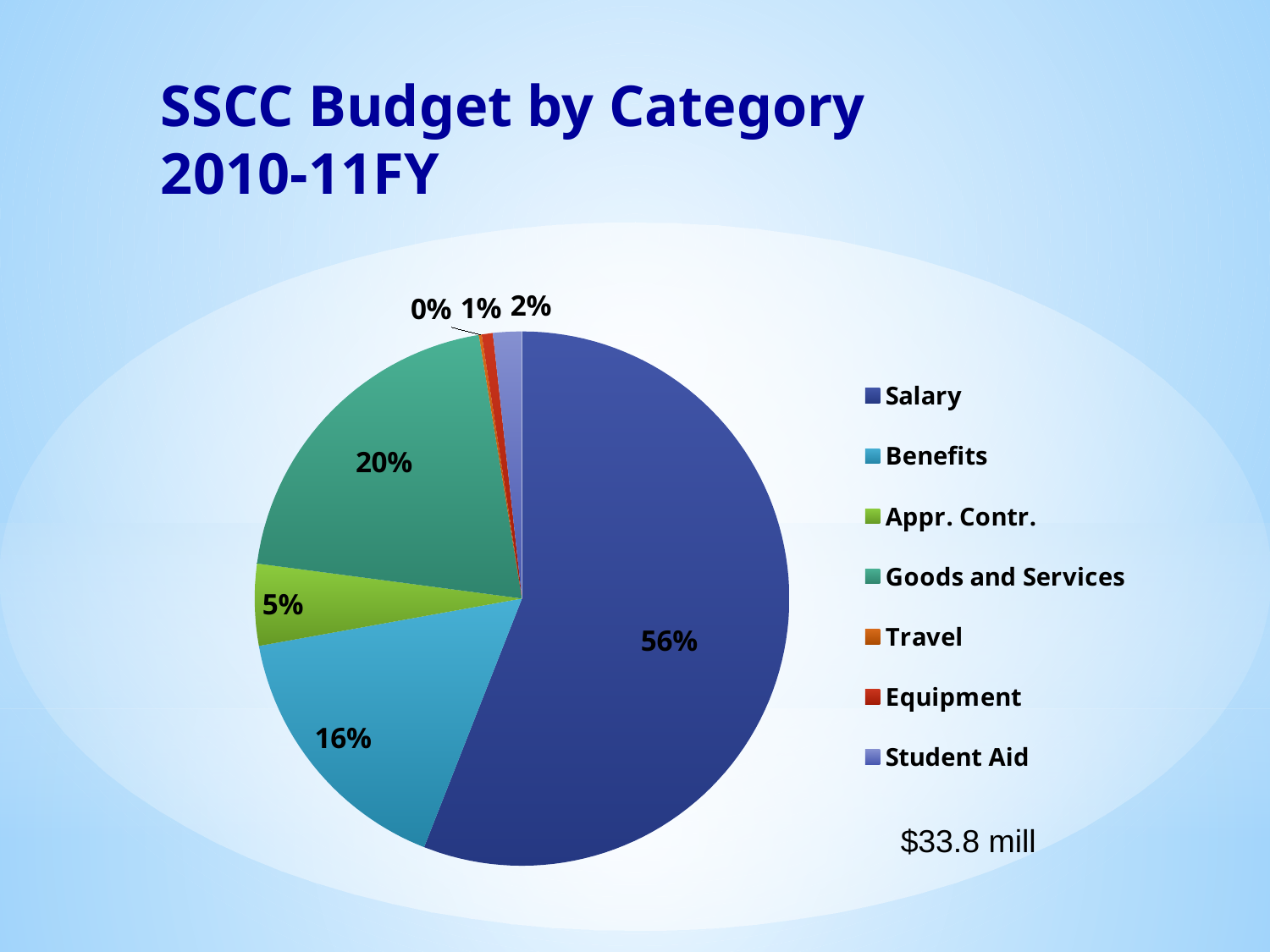
What type of chart is shown on the slide? Pie chart What share of the budget is Student Aid? 2% What share of the SSCC budget goes to Salary? 56% Which is larger, the Benefits share or the Goods and Services share? Goods and Services What percentage of the budget is Goods and Services? 20% What total budget amount is shown below the legend? $33.8 mill What share of the budget is Benefits? 16% What percentage of the budget is Appr. Contr.? 5% Which category has the smallest share of the budget? Travel How many percentage points larger is the Salary share than the Goods and Services share? 36 Which category has the largest share of the budget? Salary How many categories does the legend list? 7